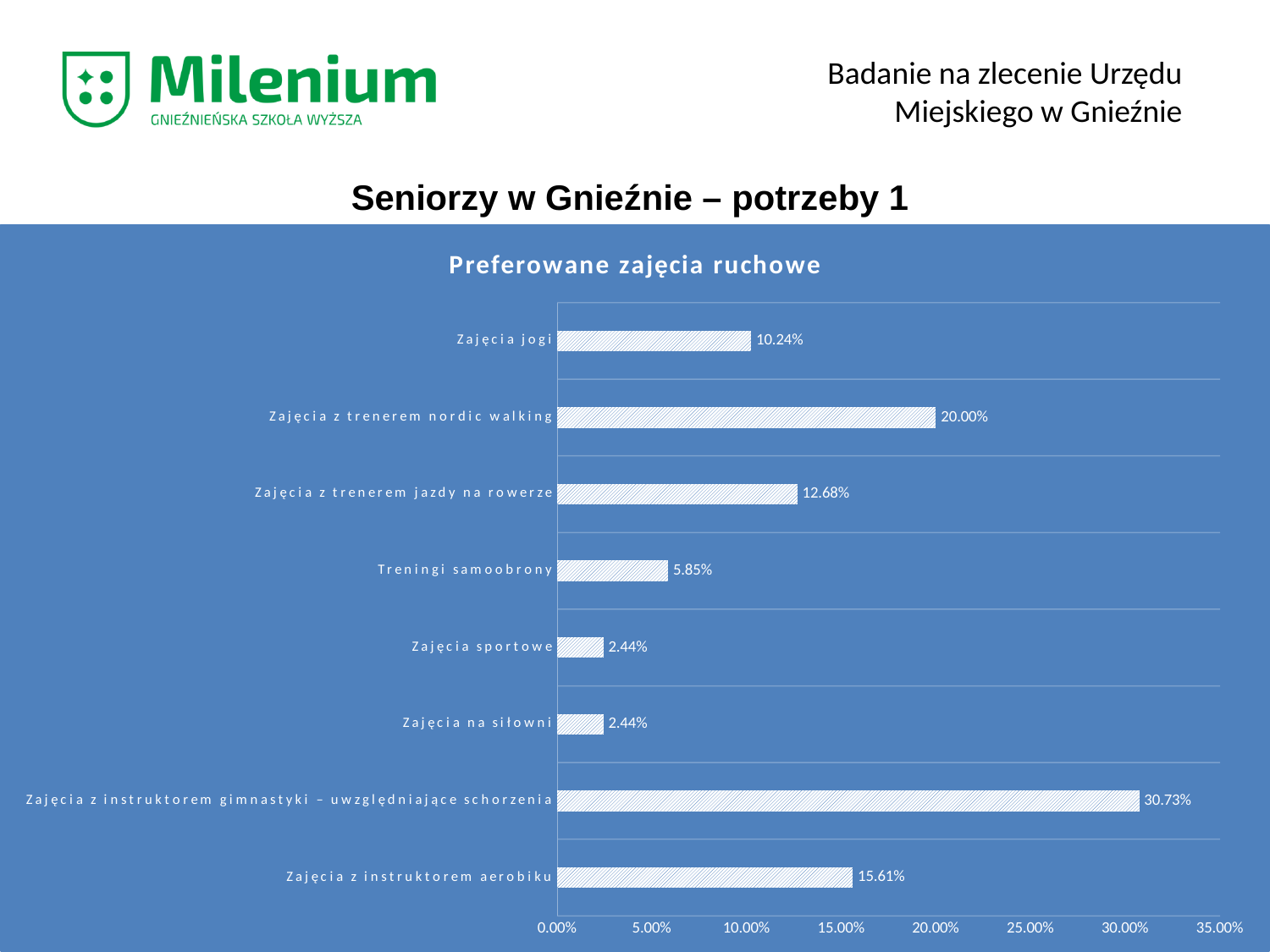
Which category has the highest value? Zajęcia z instruktorem gimnastyki – uwzględniające schorzenia Is the value for Zajęcia z instruktorem gimnastyki – uwzględniające schorzenia greater or less than 25.00%? greater What is the value for Zajęcia z instruktorem aerobiku? 15.61% What kind of chart is shown on the slide? bar chart What is the title of the chart? Preferowane zajęcia ruchowe What is the difference between the values for Zajęcia z trenerem nordic walking and Zajęcia z trenerem jazdy na rowerze? 7.32% What is the value for Zajęcia z trenerem nordic walking? 20.00% What is the value for Zajęcia jogi? 10.24% What is the value for Treningi samoobrony? 5.85% Which is larger, the value for Zajęcia z instruktorem aerobiku or the value for Zajęcia jogi? Zajęcia z instruktorem aerobiku What is the difference between the values for Zajęcia z instruktorem gimnastyki – uwzględniające schorzenia and Zajęcia z instruktorem aerobiku? 15.12% How many categories are shown in the chart? 8